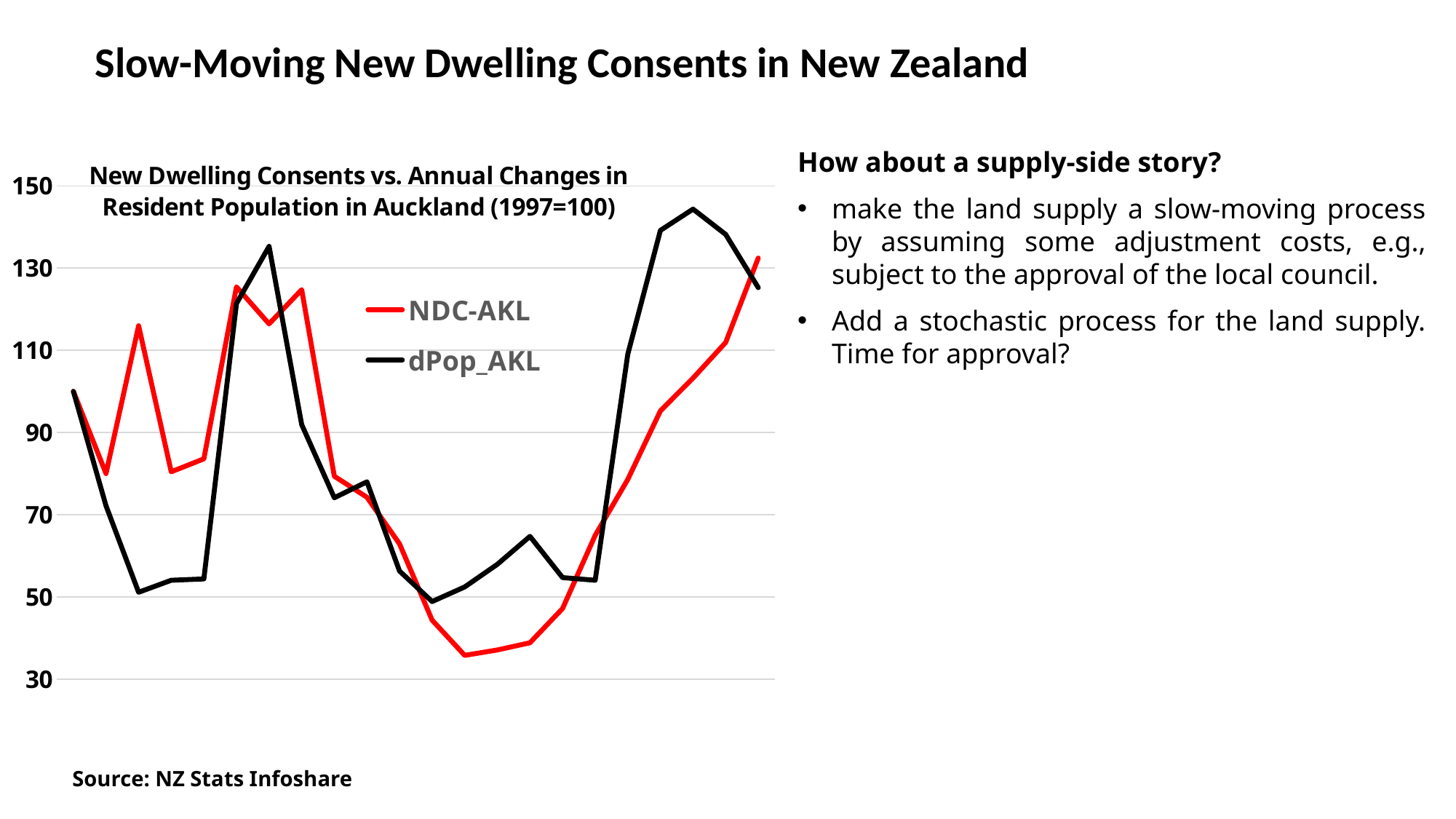
Which series reaches the higher peak value, NDC-AKL or dPop_AKL? dPop_AKL Do the values of the NDC-AKL series rise or fall over the last part of the x axis? rise Is the highest value of the dPop_AKL series greater or less than 130? greater What kind of chart is shown on the slide? line chart Is the highest value of the NDC-AKL series greater or less than 110? greater Is the lowest value of the dPop_AKL series greater or less than 70? less What colour is the NDC-AKL line in the chart? red Which series falls to the lower minimum value, NDC-AKL or dPop_AKL? NDC-AKL What is the title of the chart? New Dwelling Consents vs. Annual Changes in Resident Population in Auckland (1997=100) According to the chart title, what index value do both series take in the base year 1997? 100 How many series does the chart's legend list? 2